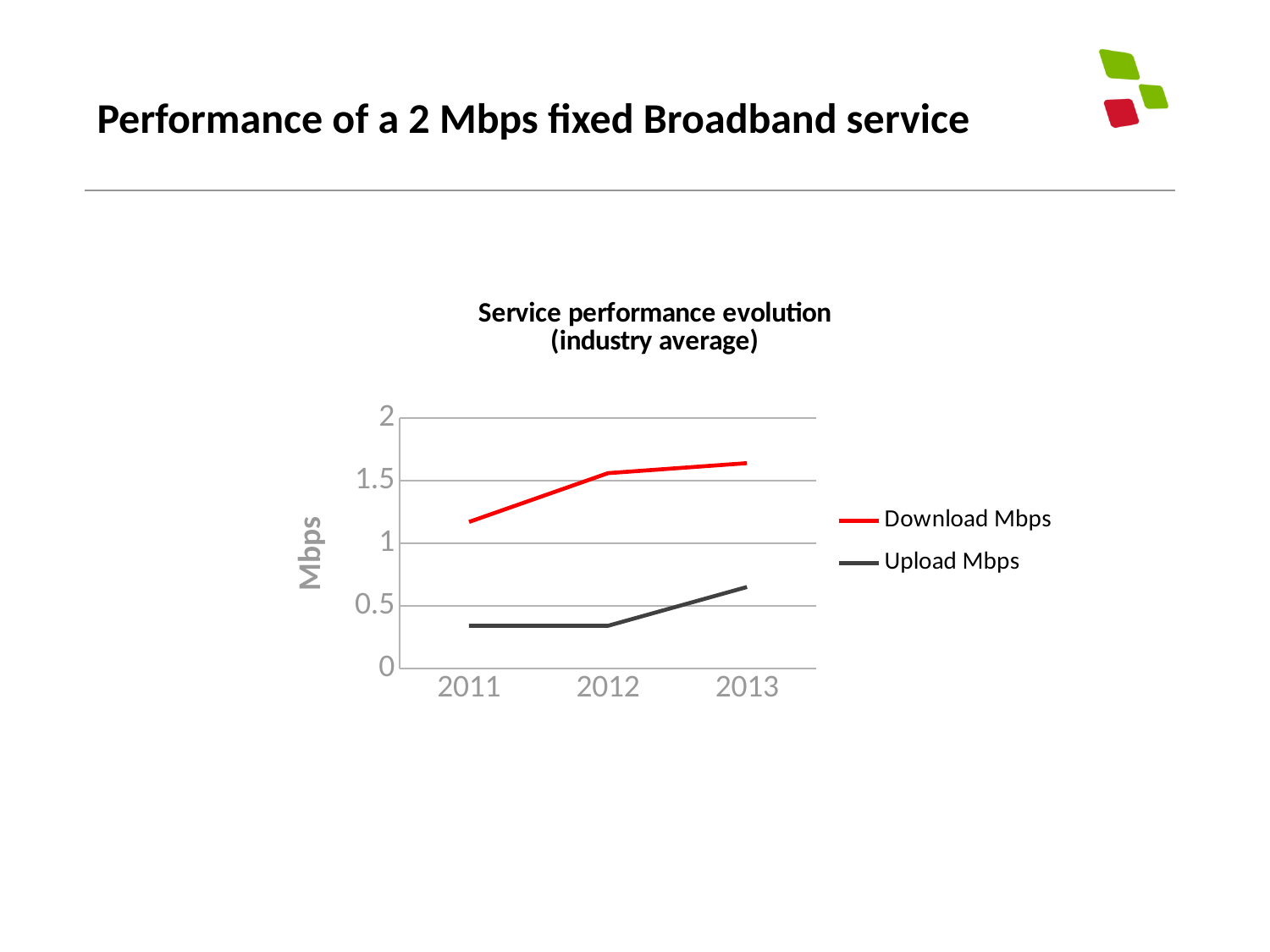
What is the label on the y axis? Mbps In 2013, which is larger, Download Mbps or Upload Mbps? Download Mbps In which year is Download Mbps highest? 2013 Is the Download Mbps value for 2013 greater or less than 2? less How many series does the legend list? 2 How many years are shown on the x axis? 3 Is the Download Mbps value for 2011 greater or less than 1? greater What kind of chart is shown on the slide? Line chart Does Download Mbps rise or fall from 2011 to 2013? Rise Is the Upload Mbps value for 2013 greater or less than 0.5? greater In which year is Download Mbps lowest? 2011